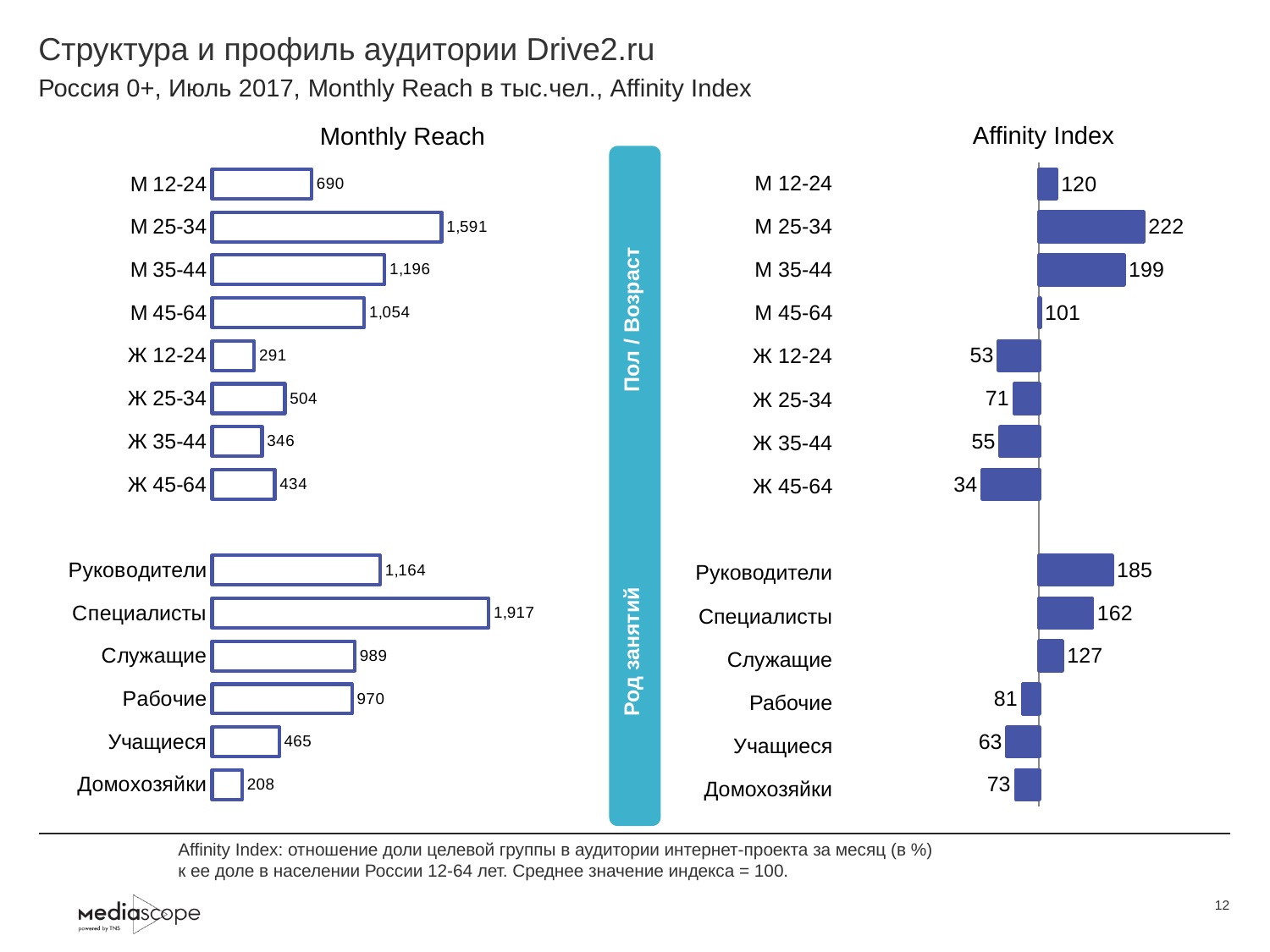
In the Monthly Reach chart, what is the value for Домохозяйки? 208 In the Monthly Reach chart, which category has the lowest value? Домохозяйки In the Affinity Index chart, what is the value for Руководители? 185 In the Monthly Reach chart, which category has the highest value? Специалисты In the Monthly Reach chart, what is the difference between the values for М 25-34 and М 35-44? 395 In the Affinity Index chart, what is the difference between the values for М 25-34 and Ж 25-34? 151 In the Affinity Index chart, which is larger: the value for М 35-44 or the value for Специалисты? М 35-44 In the Affinity Index chart, which category has the lowest value? Ж 45-64 What kind of chart is the Affinity Index chart? Bar chart What are the two group labels shown on the vertical band between the charts? Пол / Возраст and Род занятий In the Monthly Reach chart, what is the value for М 25-34? 1,591 How many categories are plotted in the Monthly Reach chart? 14